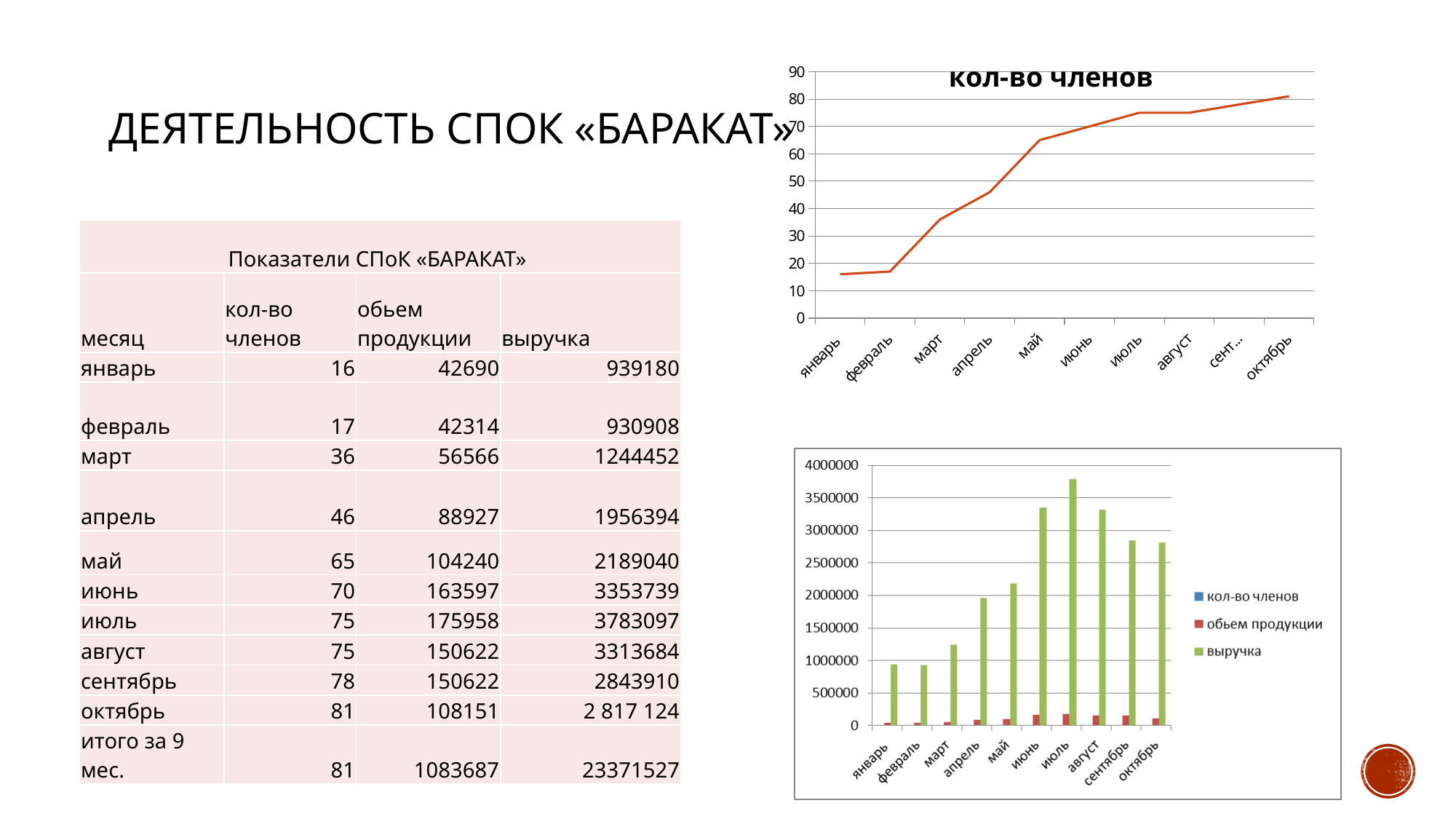
In the bottom-right bar chart, which month has the highest выручка bar? июль In the bottom-right bar chart, is the выручка value for апрель greater or less than 1500000? greater In the top-right chart «кол-во членов», which month has the highest value? октябрь What kind of chart is the bottom-right chart? bar chart What kind of chart is the top-right chart titled «кол-во членов»? line chart How many series does the legend of the bottom-right bar chart list? 3 In the top-right chart «кол-во членов», is the value for февраль greater or less than 20? less In the top-right chart «кол-во членов», which month has the lowest value? январь In the top-right chart «кол-во членов», do the values rise or fall from январь to октябрь? rise In the top-right chart «кол-во членов», how many months are plotted along the x axis? 10 In the top-right chart «кол-во членов», is the value for май greater or less than 60? greater In the bottom-right bar chart, is the выручка bar for май or for сентябрь taller? сентябрь